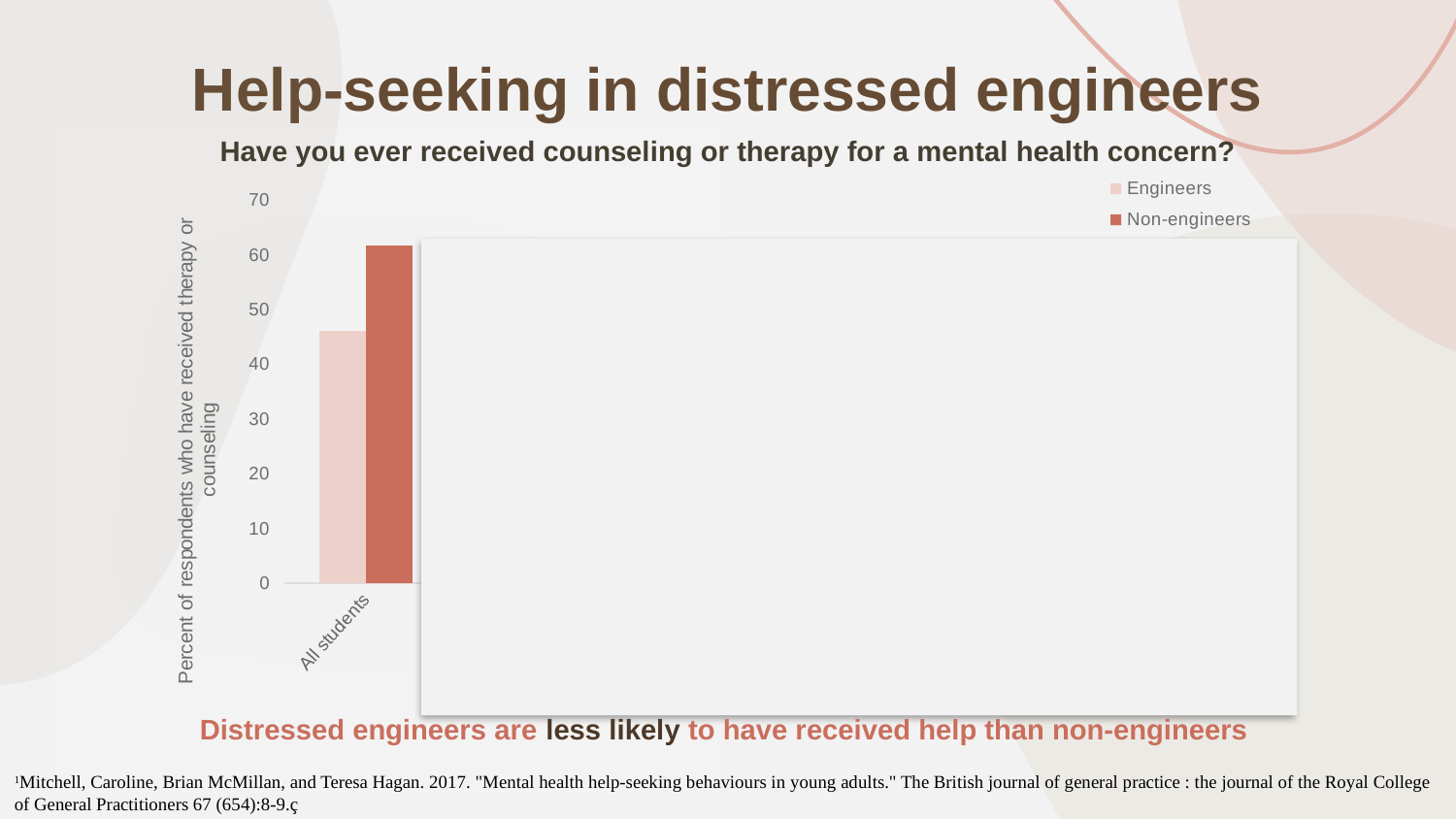
How many series does the chart legend list? 2 What is the title of the chart? Have you ever received counseling or therapy for a mental health concern? What kind of chart is shown on the slide? bar chart Is the value for Engineers among All students greater or less than 40? greater What are the two series named in the chart legend? Engineers and Non-engineers For All students, which series has the taller bar, Engineers or Non-engineers? Non-engineers How many category labels are readable on the chart's x axis? 1 Is the value for Engineers among All students greater or less than 50? less Is the value for Non-engineers among All students greater or less than 50? greater What is the highest value shown on the chart's vertical axis? 70